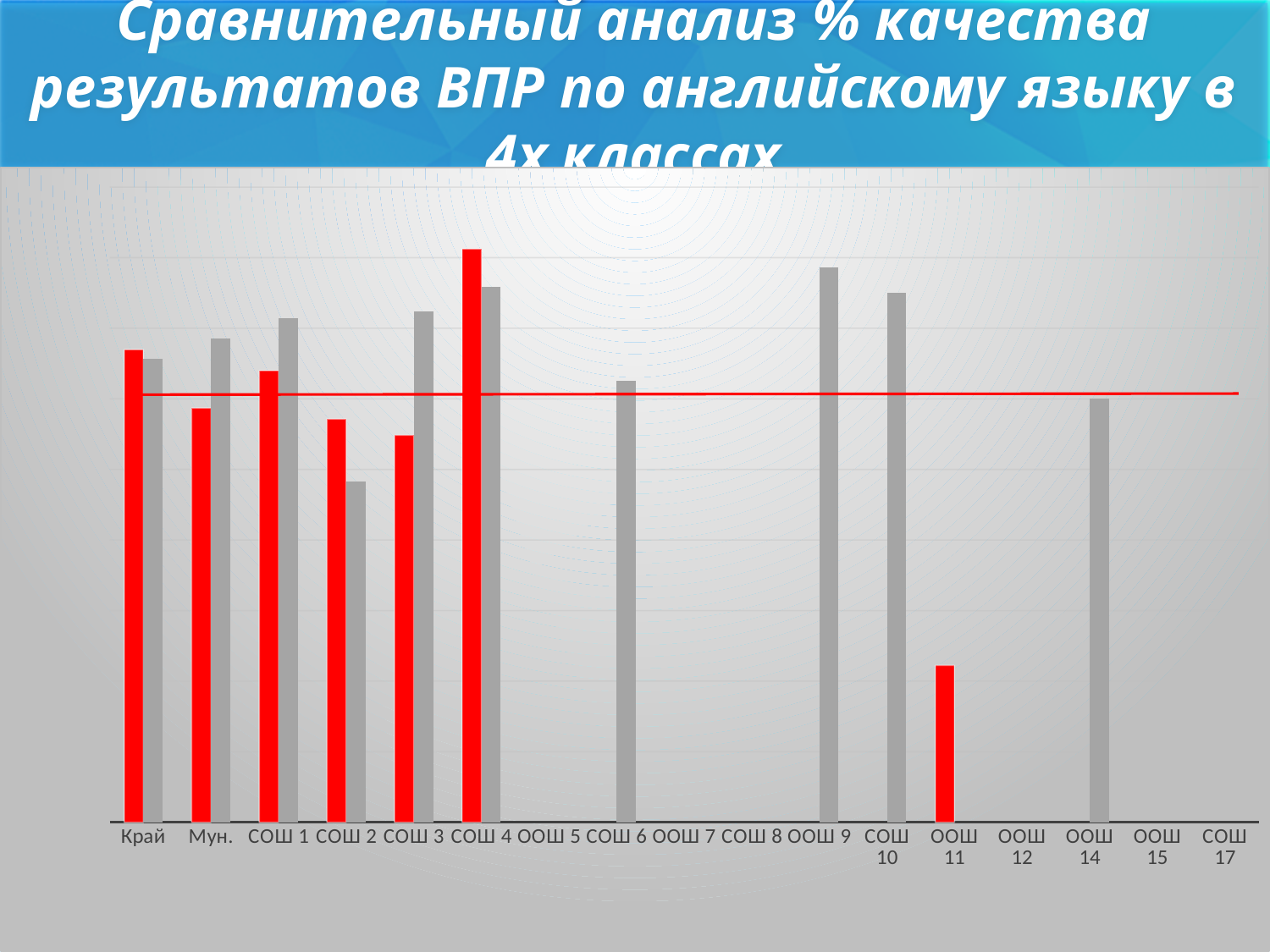
What kind of chart is shown on the slide? bar chart For СОШ 2, which bar is taller, the red one or the grey one? red Which is taller: the grey bar for СОШ 10 or the grey bar for ООШ 14? СОШ 10 What is the first category on the x axis of the chart? Край For СОШ 3, which bar is taller, the red one or the grey one? grey Which category has the tallest red bar in the chart? СОШ 4 How many categories are labelled along the x axis of the chart? 17 What two colours are used for the bars in the chart? red and grey Which category has the shortest red bar in the chart? ООШ 11 Which category has the tallest grey bar in the chart? ООШ 9